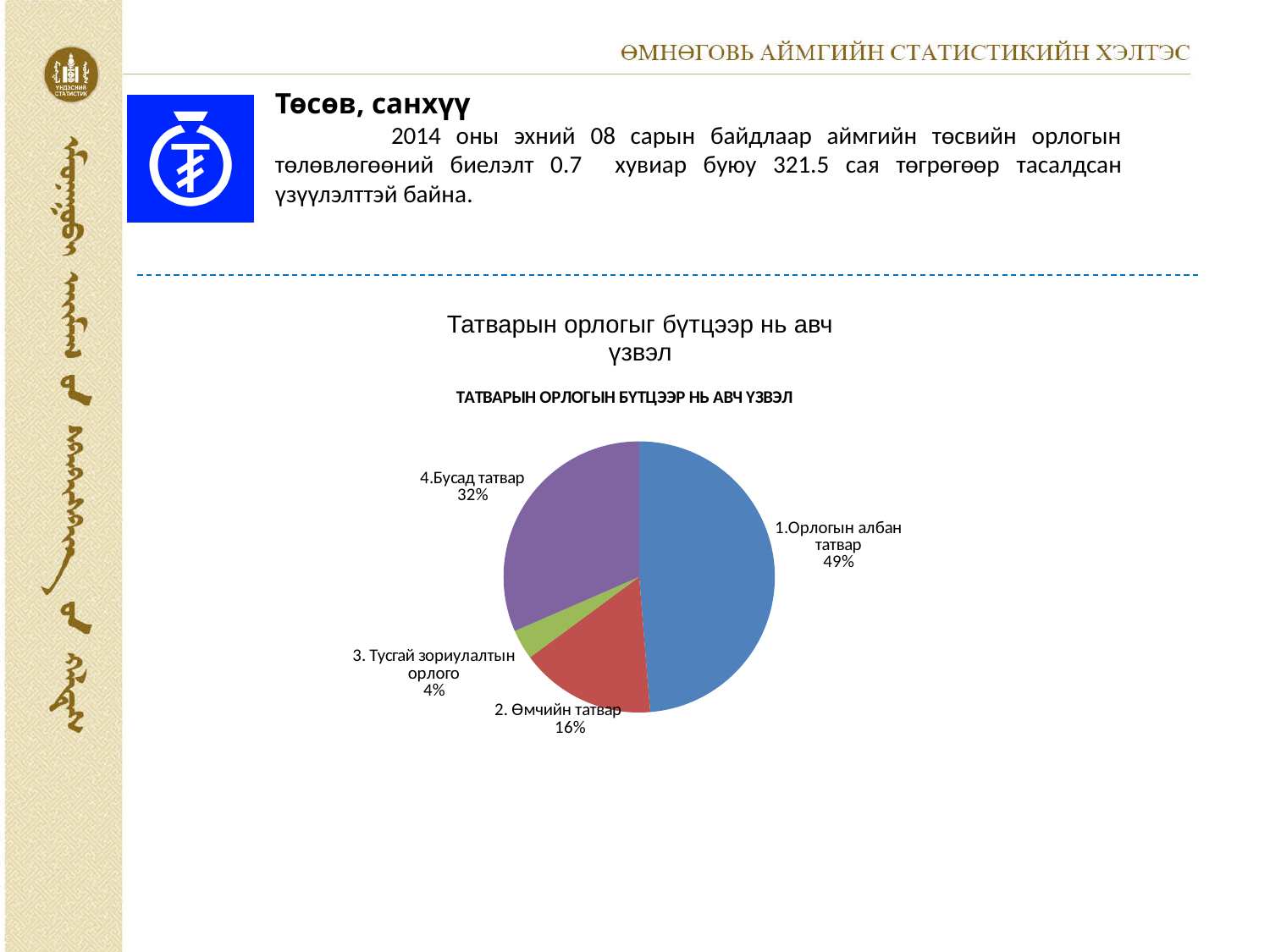
How many slices does the pie chart have? 4 What is the difference in percentage points between "1.Орлогын албан татвар" and "4.Бусад татвар"? 17 What share of the pie does "1.Орлогын албан татвар" have? 49% Which slice of the pie is the smallest? 3. Тусгай зориулалтын орлого What kind of chart is shown on the slide? pie chart Which slice of the pie is the largest? 1.Орлогын албан татвар Which is larger, the share for "2. Өмчийн татвар" or the share for "4.Бусад татвар"? 4.Бусад татвар What is the difference in percentage points between "2. Өмчийн татвар" and "3. Тусгай зориулалтын орлого"? 12 What share of the pie does "4.Бусад татвар" have? 32% What share of the pie does "3. Тусгай зориулалтын орлого" have? 4% What is the title printed directly above the pie chart? ТАТВАРЫН ОРЛОГЫН БҮТЦЭЭР НЬ АВЧ ҮЗВЭЛ